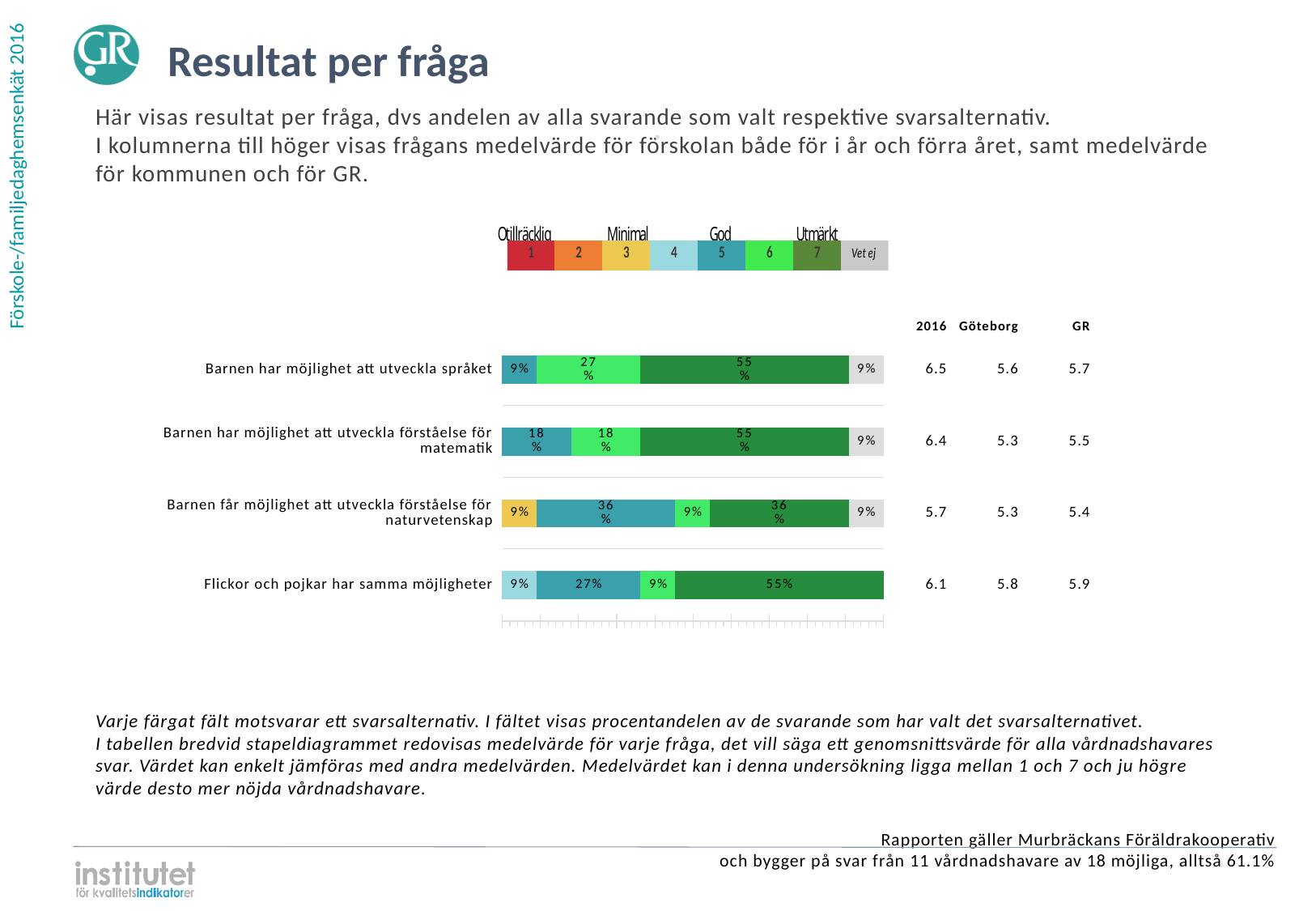
What kind of chart is shown on the slide? Stacked bar chart What percentage of respondents chose answer 6 for 'Barnen har möjlighet att utveckla språket'? 27% Which question has the smallest share of respondents choosing answer 7? Barnen får möjlighet att utveckla förståelse för naturvetenskap How many entries does the legend above the chart list? 8 What percentage of respondents chose answer 7 for 'Barnen har möjlighet att utveckla språket'? 55% What percentage of respondents chose answer 5 for 'Barnen har möjlighet att utveckla förståelse för matematik'? 18% For 'Barnen får möjlighet att utveckla förståelse för naturvetenskap', which is larger: the share choosing answer 5 or the share choosing answer 6? Answer 5 What is the 2016 mean value shown for 'Barnen har möjlighet att utveckla språket'? 6.5 What is the total of all segments in the bar for 'Barnen har möjlighet att utveckla förståelse för matematik'? 100% How many questions (categories) are plotted in the bar chart? 4 What percentage of respondents chose answer 3 for 'Barnen får möjlighet att utveckla förståelse för naturvetenskap'? 9% What is the difference between the share choosing answer 5 and the share choosing answer 6 for 'Flickor och pojkar har samma möjligheter'? 18%